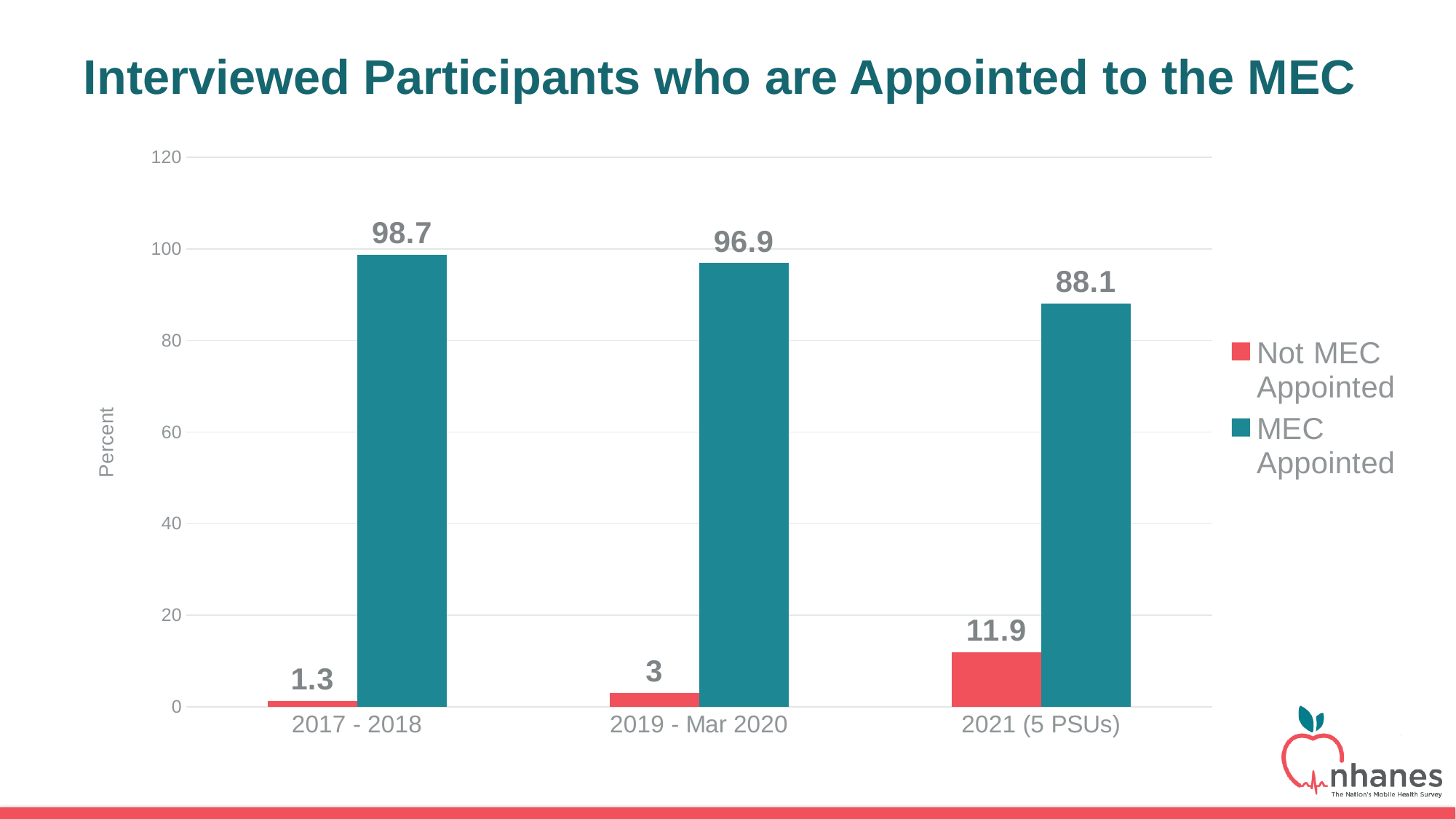
What is the value for Not MEC Appointed in 2019 - Mar 2020? 3 Do the Not MEC Appointed values rise or fall across the periods from left to right? rise Is the MEC Appointed value for 2021 (5 PSUs) greater or less than 80? greater Which period has the highest MEC Appointed value? 2017 - 2018 How many periods are shown on the x axis? 3 What is the value for MEC Appointed in 2017 - 2018? 98.7 What is the value for Not MEC Appointed in 2021 (5 PSUs)? 11.9 Which is larger: the MEC Appointed value for 2019 - Mar 2020 or for 2021 (5 PSUs)? 2019 - Mar 2020 Which period has the lowest Not MEC Appointed value? 2017 - 2018 How many series does the legend list? 2 What is the difference between the MEC Appointed values for 2017 - 2018 and 2021 (5 PSUs)? 10.6 What kind of chart is shown on the slide? bar chart